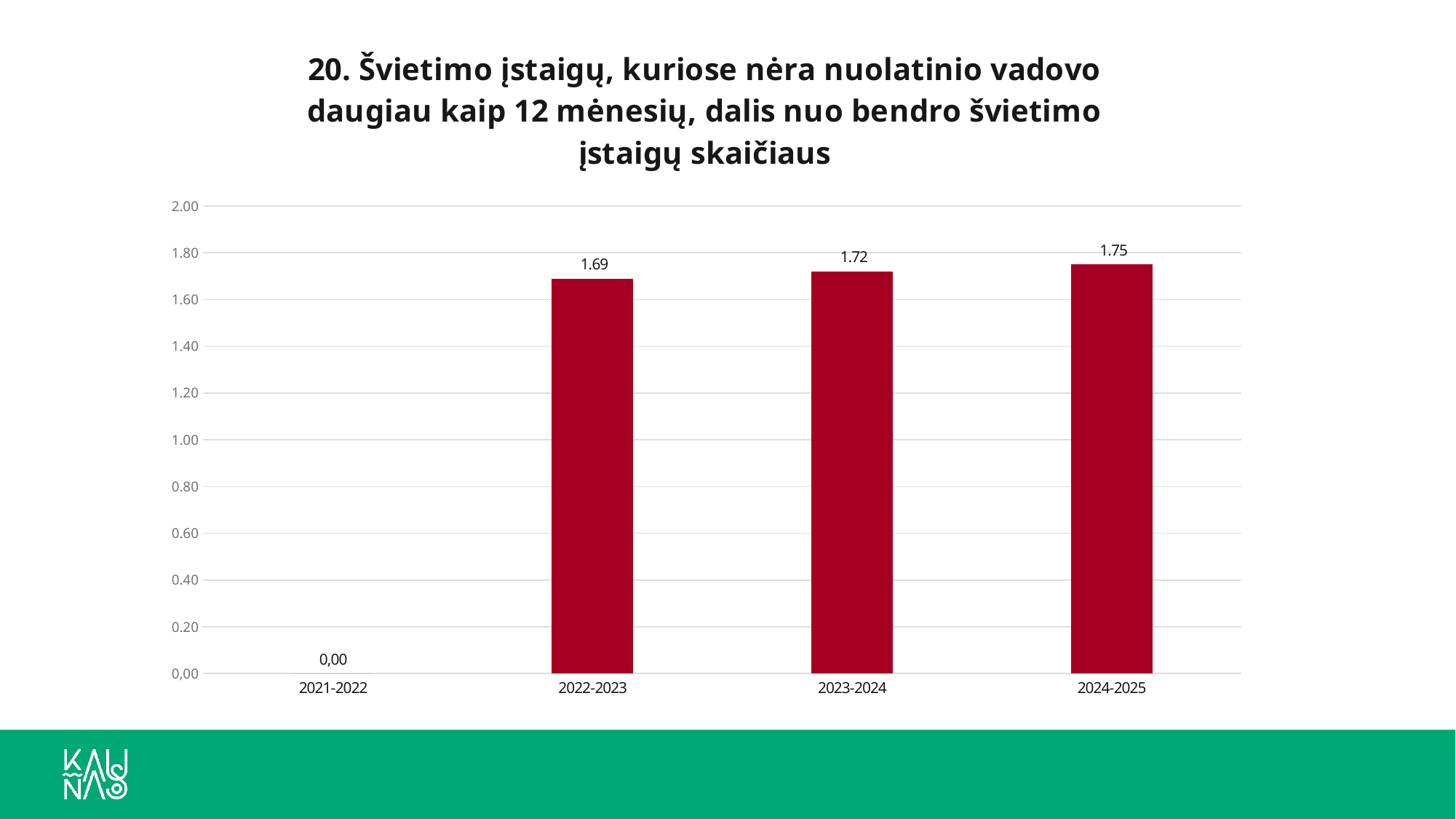
What is the value for 2021-2022? 0,00 What is the value for 2024-2025? 1.75 Which period has the highest value? 2024-2025 What is the difference between the values for 2024-2025 and 2022-2023? 0.06 What kind of chart is shown on the slide? bar chart How many periods are shown on the x axis? 4 Is the value for 2023-2024 greater or less than 1.80? less Which period has the lowest value? 2021-2022 What is the difference between the values for 2023-2024 and 2022-2023? 0.03 Which is larger, the value for 2022-2023 or the value for 2024-2025? 2024-2025 What is the value for 2023-2024? 1.72 What is the value for 2022-2023? 1.69